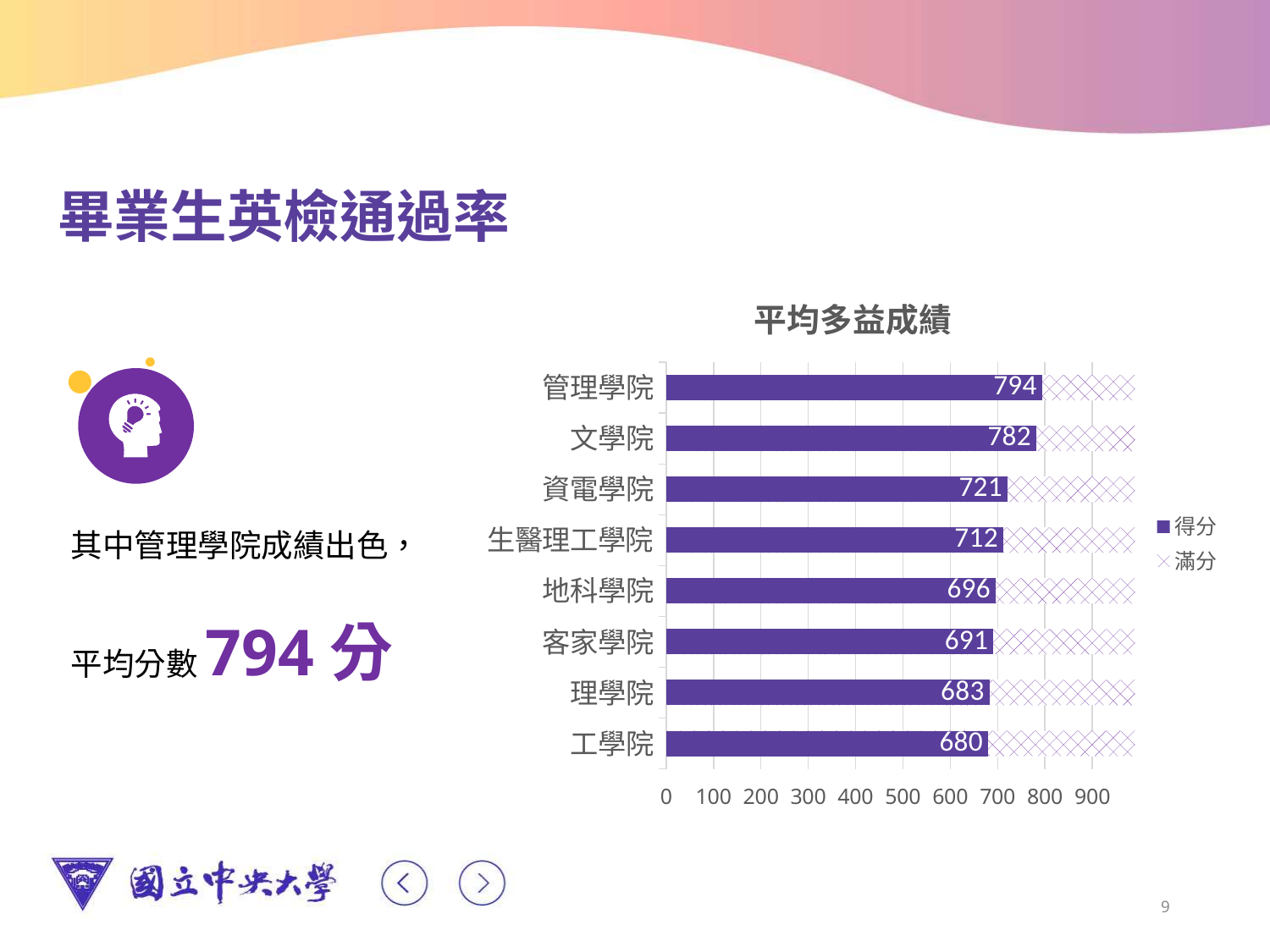
What is the difference between the 得分 values of 管理學院 and 工學院? 114 What is the 得分 value for 工學院? 680 Which has a higher 得分 value, 地科學院 or 客家學院? 地科學院 Which college has the highest 得分 value? 管理學院 What type of chart is shown on the slide? Bar chart How many colleges are shown in the chart? 8 What is the difference between the 得分 values of 資電學院 and 生醫理工學院? 9 How many series does the legend list? 2 What is the 得分 value for 生醫理工學院? 712 What is the average TOEIC score (得分) for 管理學院? 794 Which college has the lowest 得分 value? 工學院 What is the 得分 value for 文學院? 782